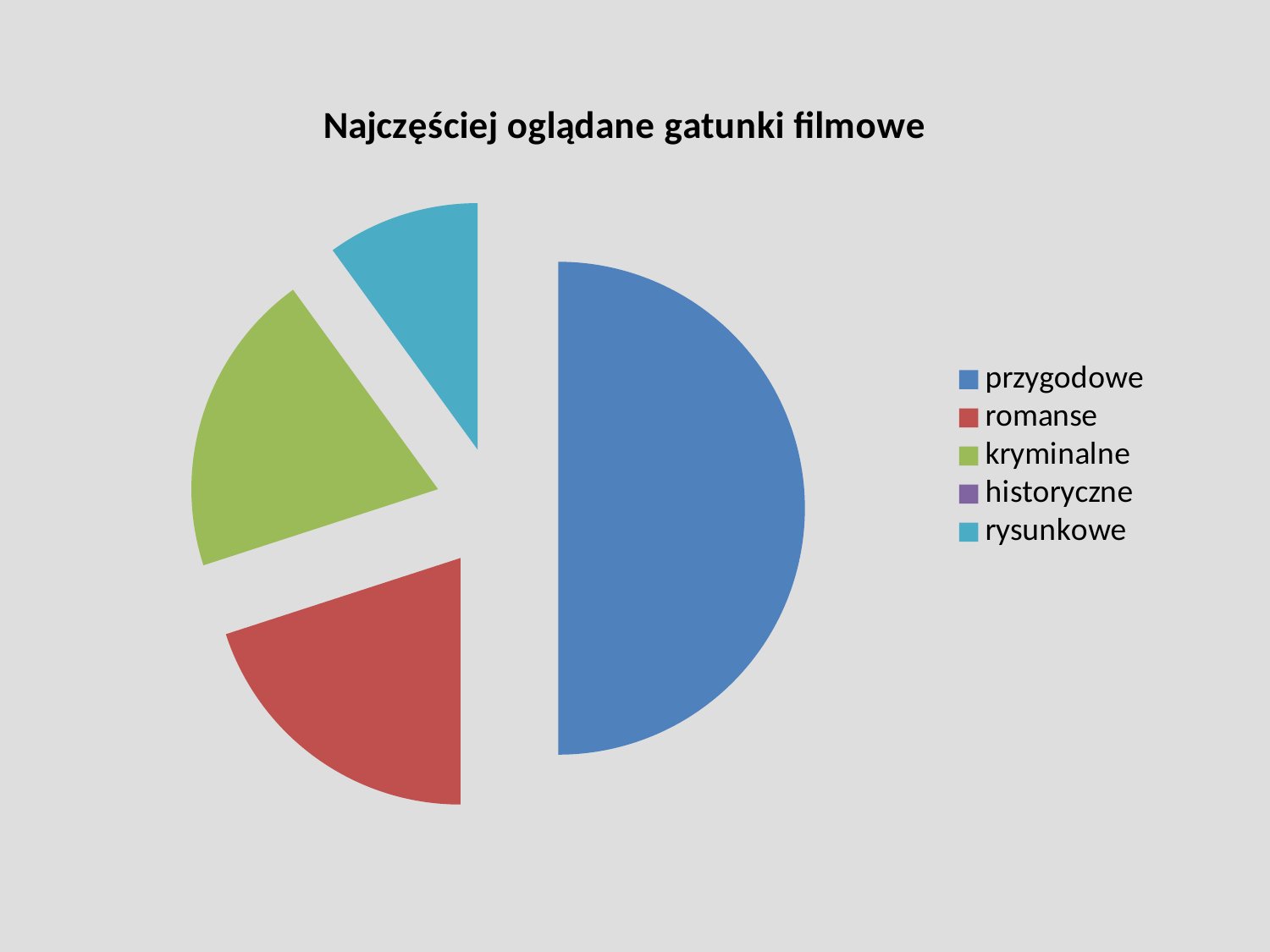
What is the title of the chart? Najczęściej oglądane gatunki filmowe What kind of chart is shown on the slide? pie chart Which category has the largest slice of the pie? przygodowe Which slice is larger, rysunkowe or kryminalne? kryminalne What colour is the przygodowe slice? blue Which of the visible slices is the smallest? rysunkowe Which slice is larger, przygodowe or kryminalne? przygodowe How many categories does the legend list? 5 Which slice is larger, przygodowe or romanse? przygodowe